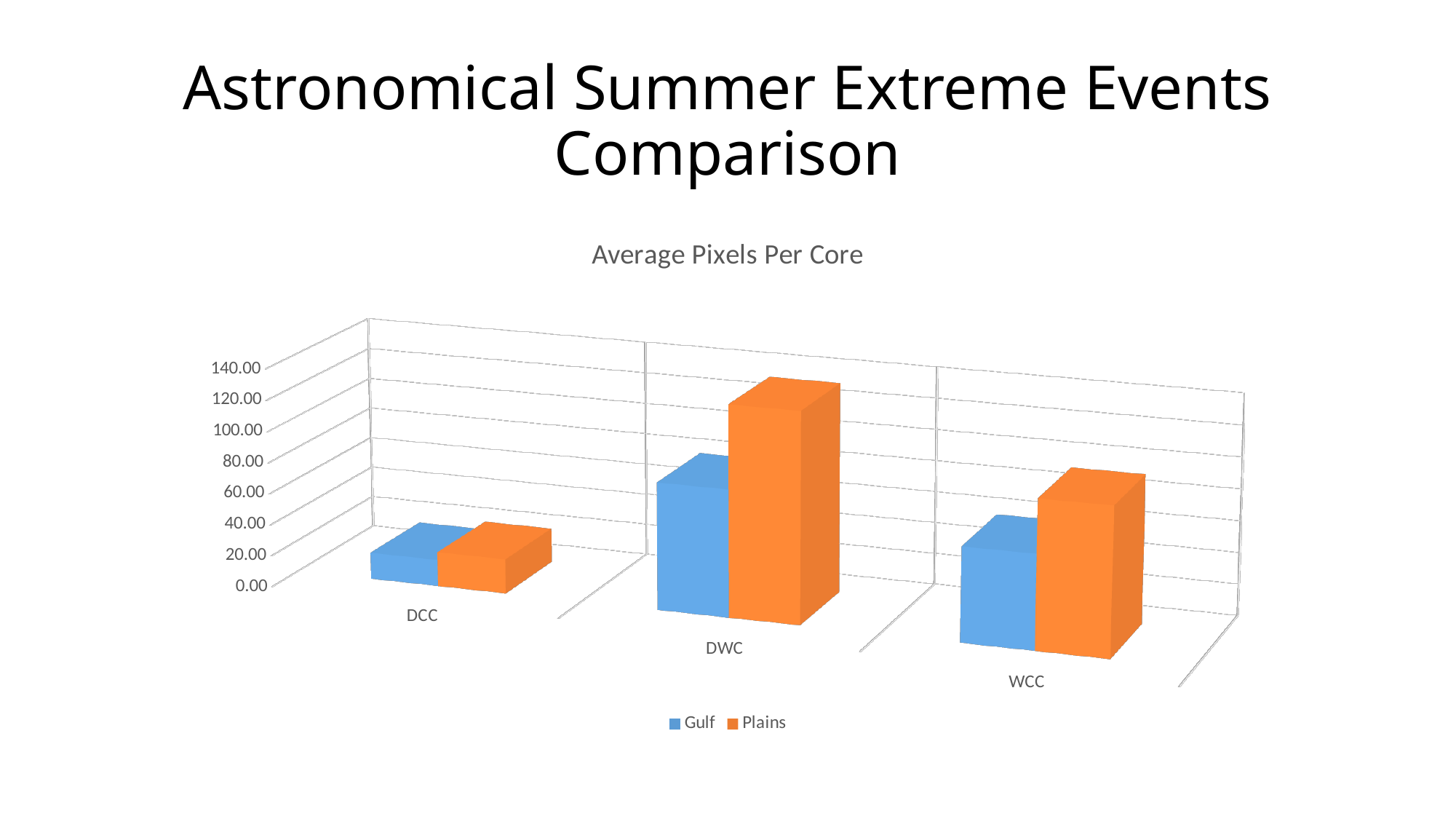
Which category has the highest Plains value? DWC How many categories are shown on the x axis? 3 Is the Gulf value for DCC greater or less than 40? less Which category has the lowest Gulf value? DCC How many series does the legend list? 2 Is the Plains value for DCC greater or less than 60? less What is the title of the chart? Average Pixels Per Core Is the Gulf value for DWC greater or less than 40? greater What kind of chart is shown on the slide? bar chart Which series is shown in orange? Plains Which is larger, the Gulf value for DWC or the Gulf value for WCC? DWC